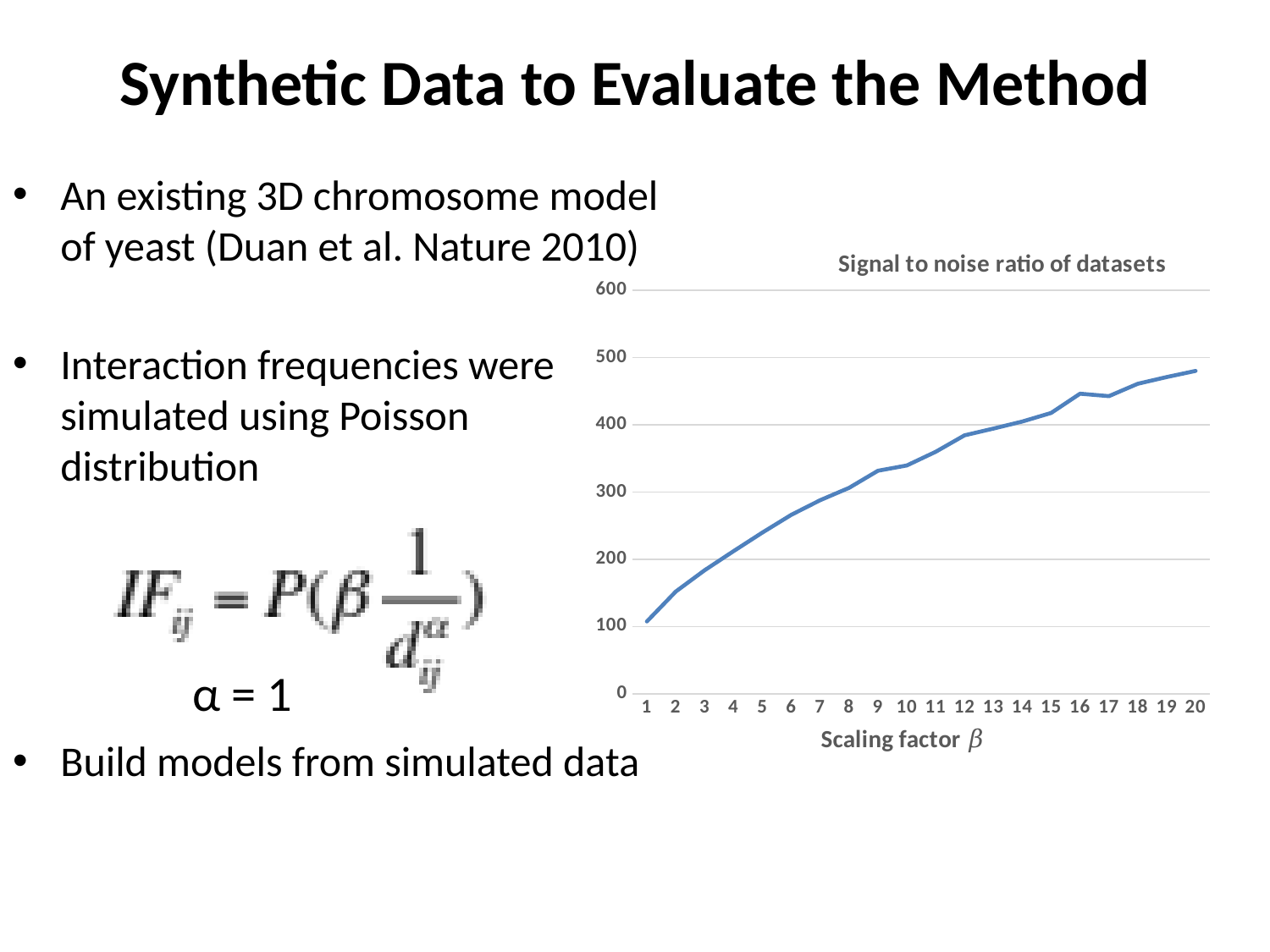
What kind of chart is shown on the slide? line chart Is the value for scaling factor 20 greater or less than 400? greater At which scaling factor is the signal to noise ratio lowest? 1 Which has a larger signal to noise ratio, scaling factor 3 or scaling factor 15? scaling factor 15 What is the title of the chart? Signal to noise ratio of datasets Is the value for scaling factor 5 greater or less than 200? greater Is the value for scaling factor 9 greater or less than 300? greater What is the label of the x axis of the chart? Scaling factor β Do the values in the chart rise or fall as the scaling factor increases from 1 to 20? rise How many scaling factor values are plotted on the x axis of the chart? 20 At which scaling factor is the signal to noise ratio highest? 20